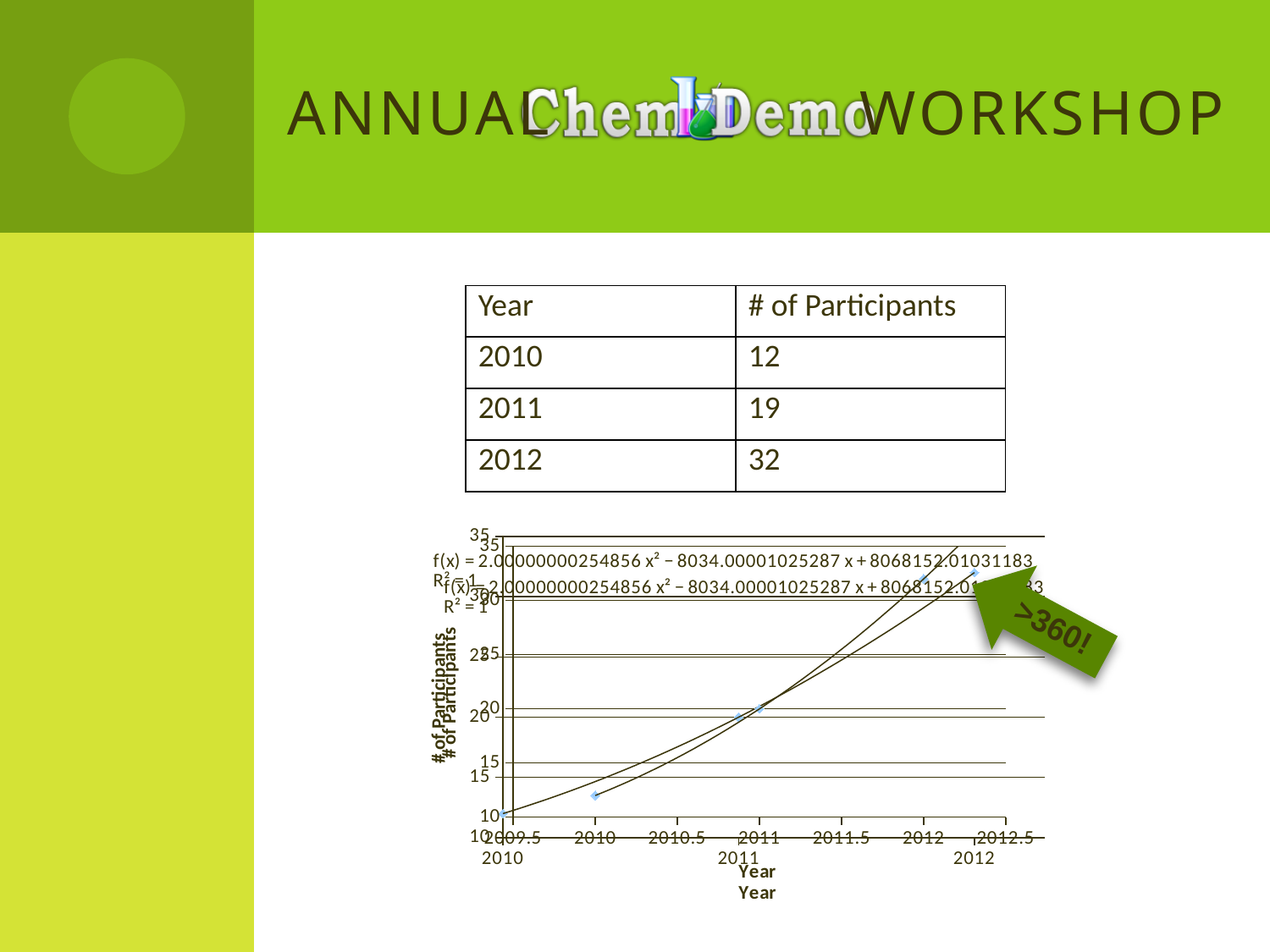
Is the number of participants plotted for 2010 greater or less than 15? less Which year has more participants, 2011 or 2012? 2012 Do the plotted values rise or fall as the year increases along the x axis? rise Is the number of participants plotted for 2011 greater or less than 15? greater Which year has the highest number of participants on the chart? 2012 What is the title of the x axis on the chart? Year Which year has the lowest number of participants on the chart? 2010 What is the title of the y axis on the chart? # of Participants Using the values in the table on the slide, what is the difference in participants between 2012 and 2010? 20 According to the table on the slide, how many participants were there in 2011? 19 Is the number of participants plotted for 2012 greater or less than 30? greater